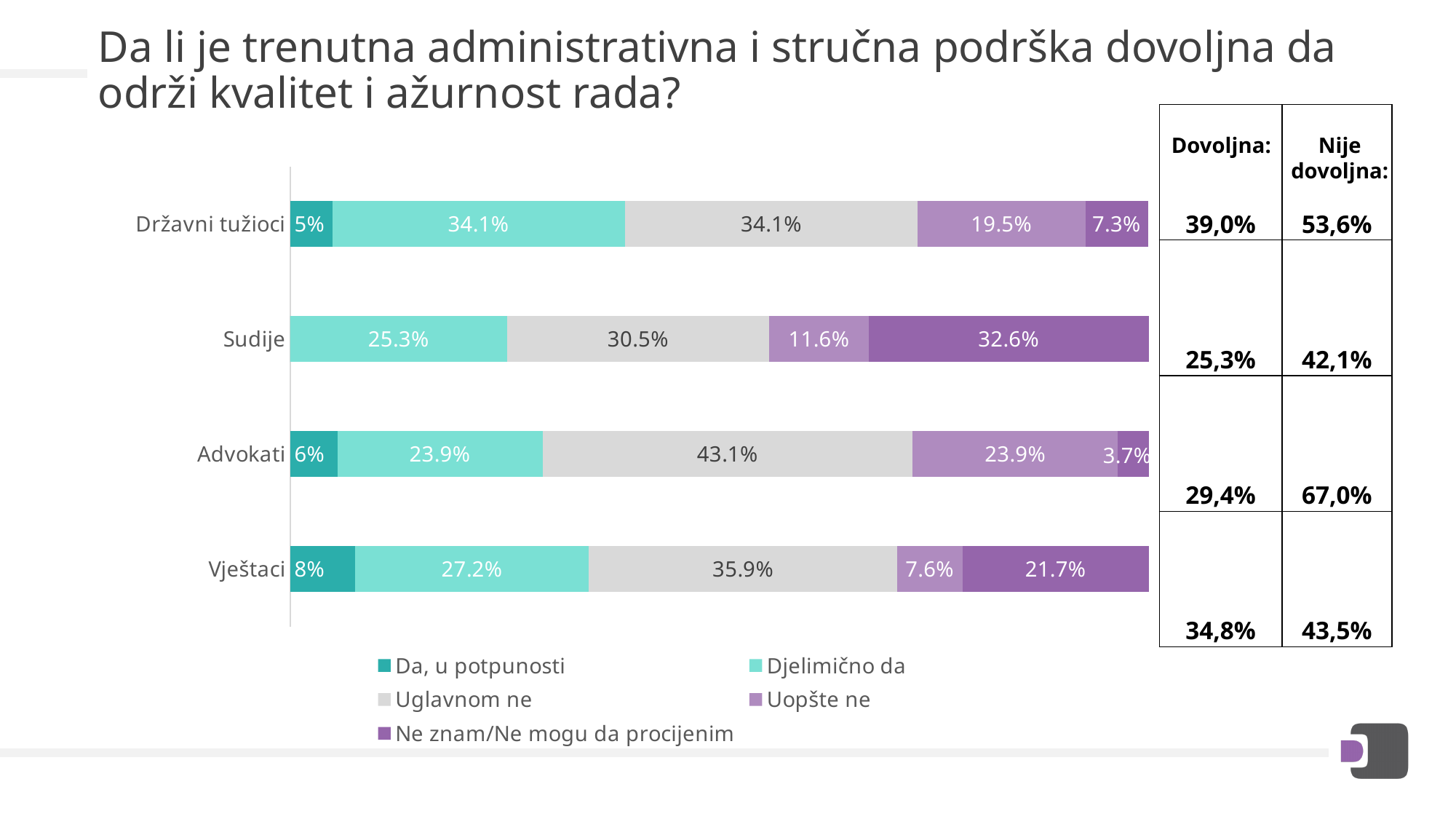
Which legend entry is shown in the darkest purple colour? Ne znam/Ne mogu da procijenim What type of chart is shown on the slide? stacked bar chart What is the value of 'Djelimično da' for Vještaci? 27.2% What is the value of 'Ne znam/Ne mogu da procijenim' for Sudije? 32.6% What is the difference between the 'Djelimično da' values for Državni tužioci and Sudije? 8.8% What is the value of 'Uopšte ne' for Državni tužioci? 19.5% How many categories (groups) are shown on the chart? 4 Which category has the highest value for 'Uglavnom ne'? Advokati Which is larger: 'Uopšte ne' for Advokati or 'Uopšte ne' for Vještaci? Advokati How many series does the legend list? 5 What is the value of 'Uglavnom ne' for Advokati? 43.1% Which category has the lowest value for 'Ne znam/Ne mogu da procijenim'? Advokati